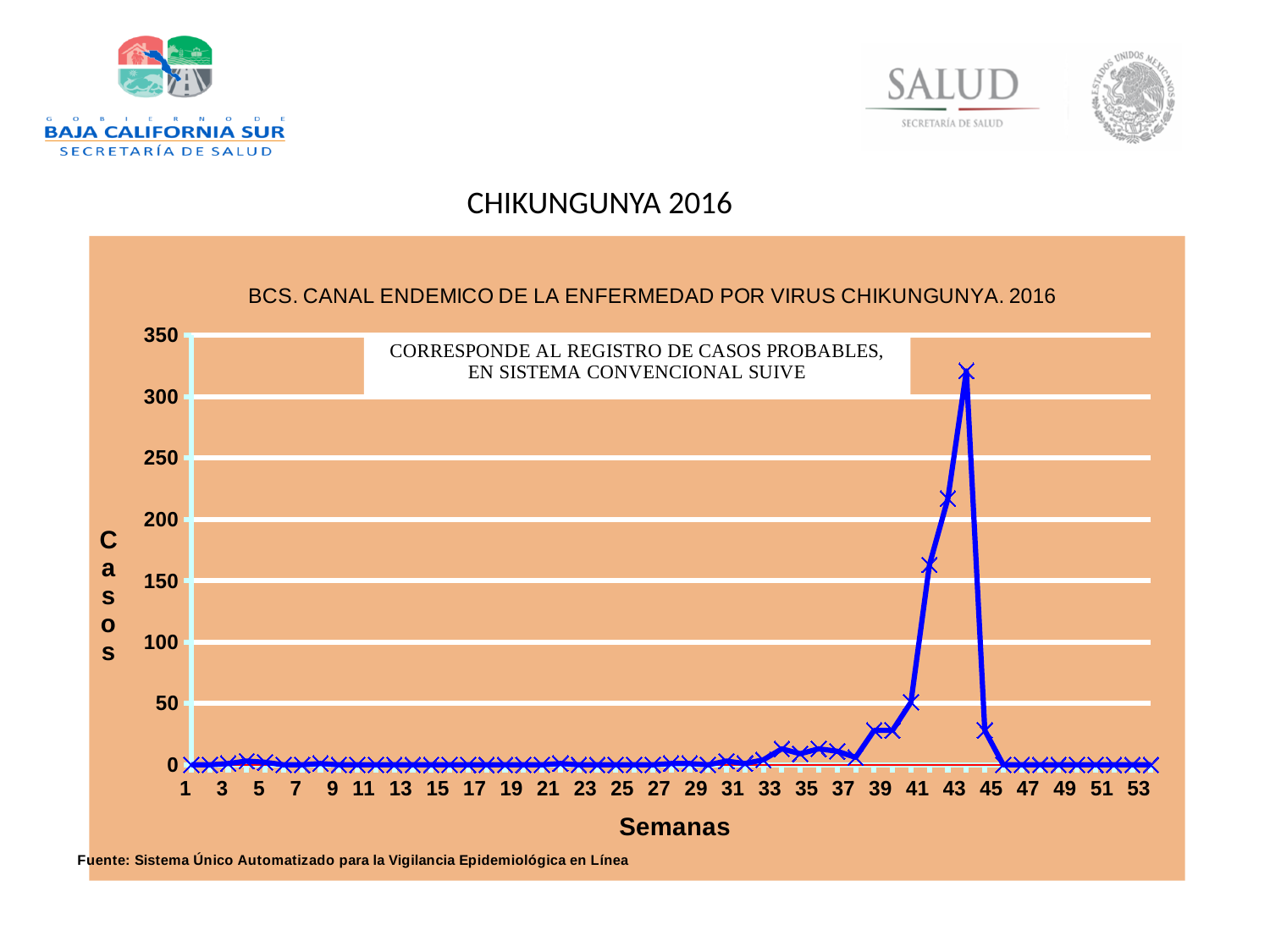
Is the value for week 43 greater or less than 200? greater Is the value for week 42 greater or less than 150? greater Is the value for week 45 greater or less than 50? less How many weeks are plotted along the x axis? 53 Do the values rise or fall between week 44 and week 46? fall What kind of chart is shown on the slide? line chart Which week has more cases, week 43 or week 44? week 43 In which week does the number of cases reach its highest value? 43 Which week has more cases, week 35 or week 42? week 42 What is the label of the x axis? Semanas